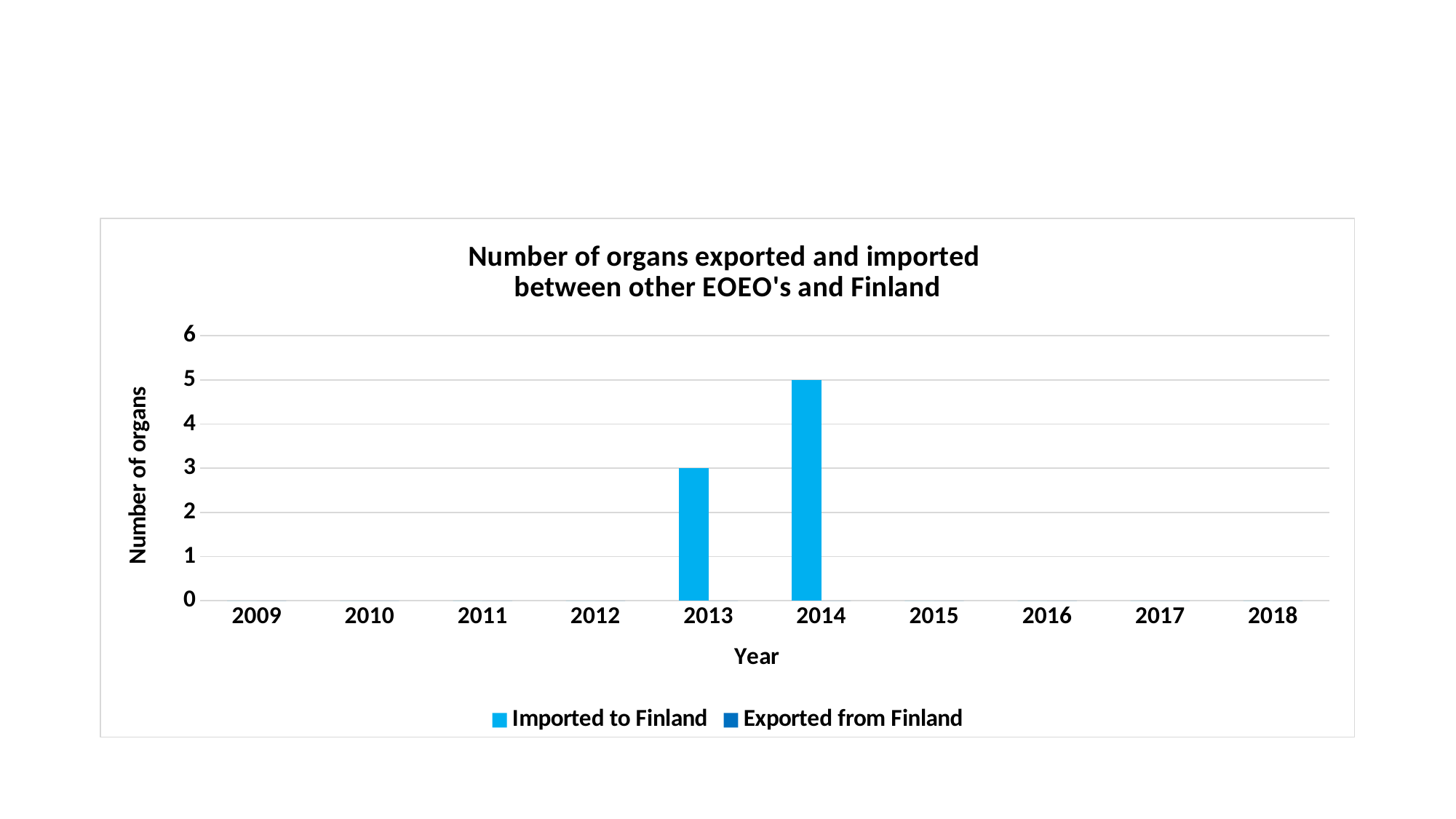
What is the value for Imported to Finland in 2014? 5 Which is larger, the Imported to Finland value for 2013 or for 2014? 2014 How many series does the legend list? 2 Does the Imported to Finland value rise or fall from 2013 to 2014? rise Which year has the highest value for Imported to Finland? 2014 Is the value for Imported to Finland in 2014 greater or less than 4? greater How many years are shown on the x axis? 10 What is the label of the y axis? Number of organs What is the title of the chart? Number of organs exported and imported between other EOEO's and Finland What is the value for Imported to Finland in 2013? 3 What kind of chart is shown on the slide? bar chart What is the difference between the Imported to Finland values for 2014 and 2013? 2